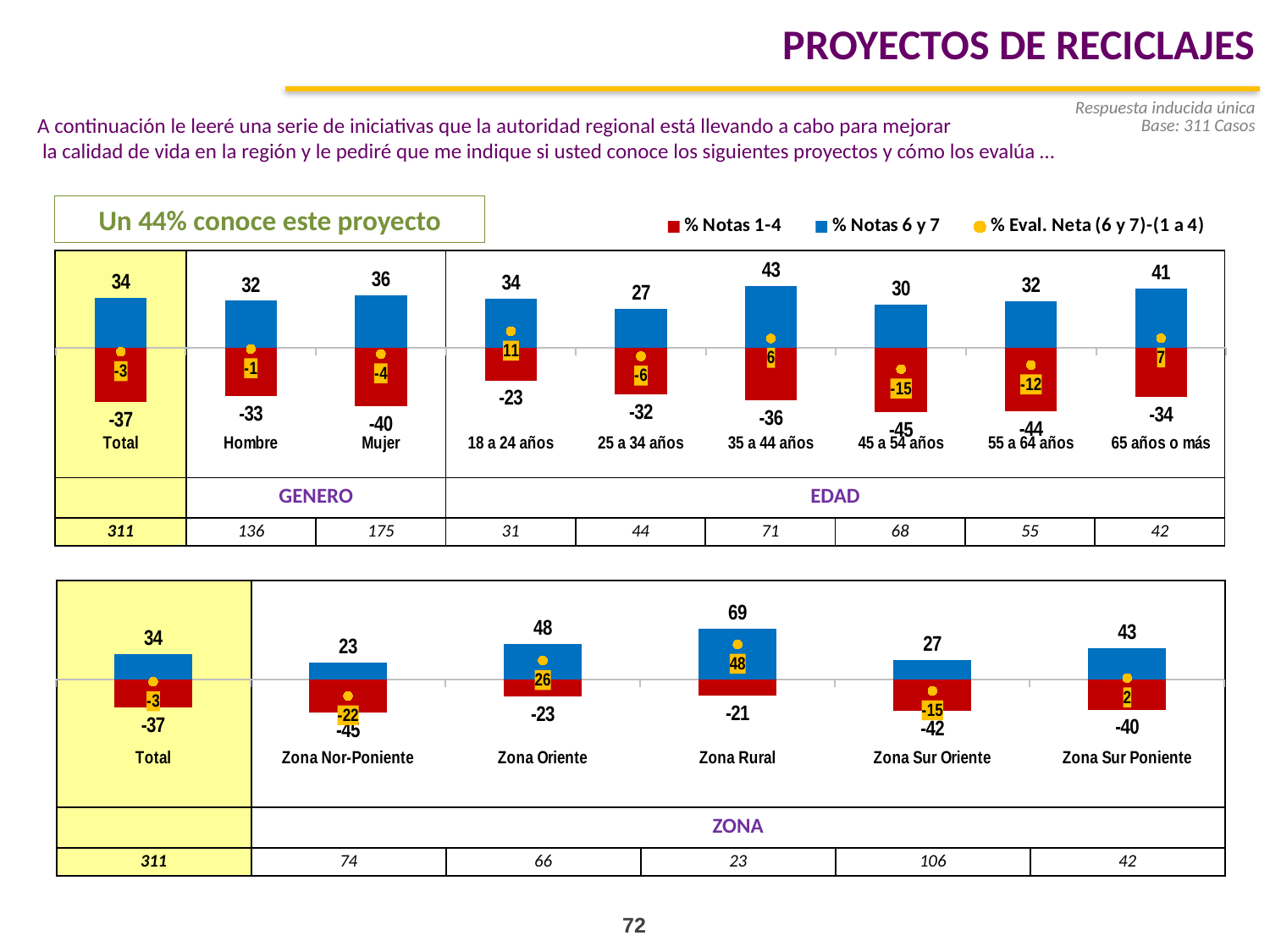
In the top chart, what is the % Notas 1-4 value for 45 a 54 años? -45 How many zone categories (excluding Total) are shown in the bottom chart? 5 In the bottom chart, which zone has the highest % Eval. Neta value? Zona Rural How many series does the legend list? 3 In the bottom chart, which is larger, the % Notas 6 y 7 value for Zona Oriente or for Zona Sur Poniente? Zona Oriente In the top chart, what is the % Eval. Neta value for 18 a 24 años? 11 In the bottom chart, what is the % Notas 6 y 7 value for Zona Rural? 69 In the top chart, which category has the lowest % Eval. Neta value? 45 a 54 años In the top chart, which age group has the highest % Notas 6 y 7 value? 35 a 44 años In the top chart, what is the difference between the % Notas 6 y 7 values for Mujer and Hombre? 4 In the bottom chart, what is the % Eval. Neta value for Zona Nor-Poniente? -22 In the top chart, what is the % Notas 6 y 7 value for Mujer? 36